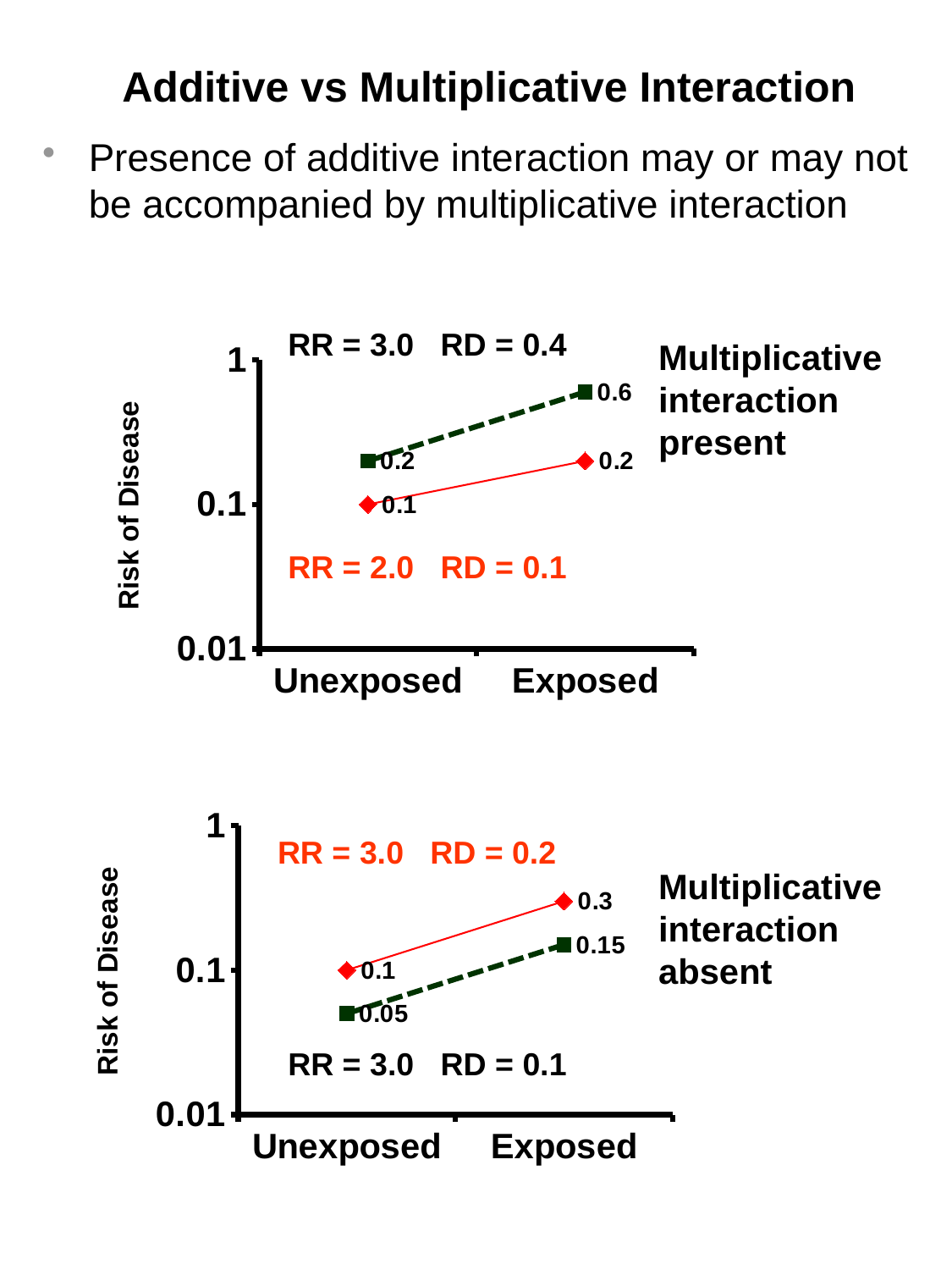
What kind of chart is the top chart (multiplicative interaction present)? line chart What is the y-axis label of the bottom chart? Risk of Disease In the bottom chart (multiplicative interaction absent), do the values rise or fall from Unexposed to Exposed? rise In the bottom chart (multiplicative interaction absent), what is the risk of disease for the Exposed group on the red solid line? 0.3 How many categories are shown on the x axis of the top chart? 2 In the top chart (multiplicative interaction present), what is the risk of disease for the Unexposed group on the red solid line? 0.1 In the top chart (multiplicative interaction present), which group has the higher risk of disease on the red solid line, Unexposed or Exposed? Exposed In the top chart (multiplicative interaction present), what is the risk of disease for the Exposed group on the green dashed line? 0.6 In the bottom chart (multiplicative interaction absent), which point has the lowest risk of disease? Unexposed on the green dashed line (0.05) In the top chart (multiplicative interaction present), what is the difference between the Exposed and Unexposed values on the green dashed line? 0.4 In the bottom chart (multiplicative interaction absent), what is the risk of disease for the Unexposed group on the green dashed line? 0.05 In the bottom chart (multiplicative interaction absent), what is the difference between the Exposed and Unexposed values on the green dashed line? 0.1